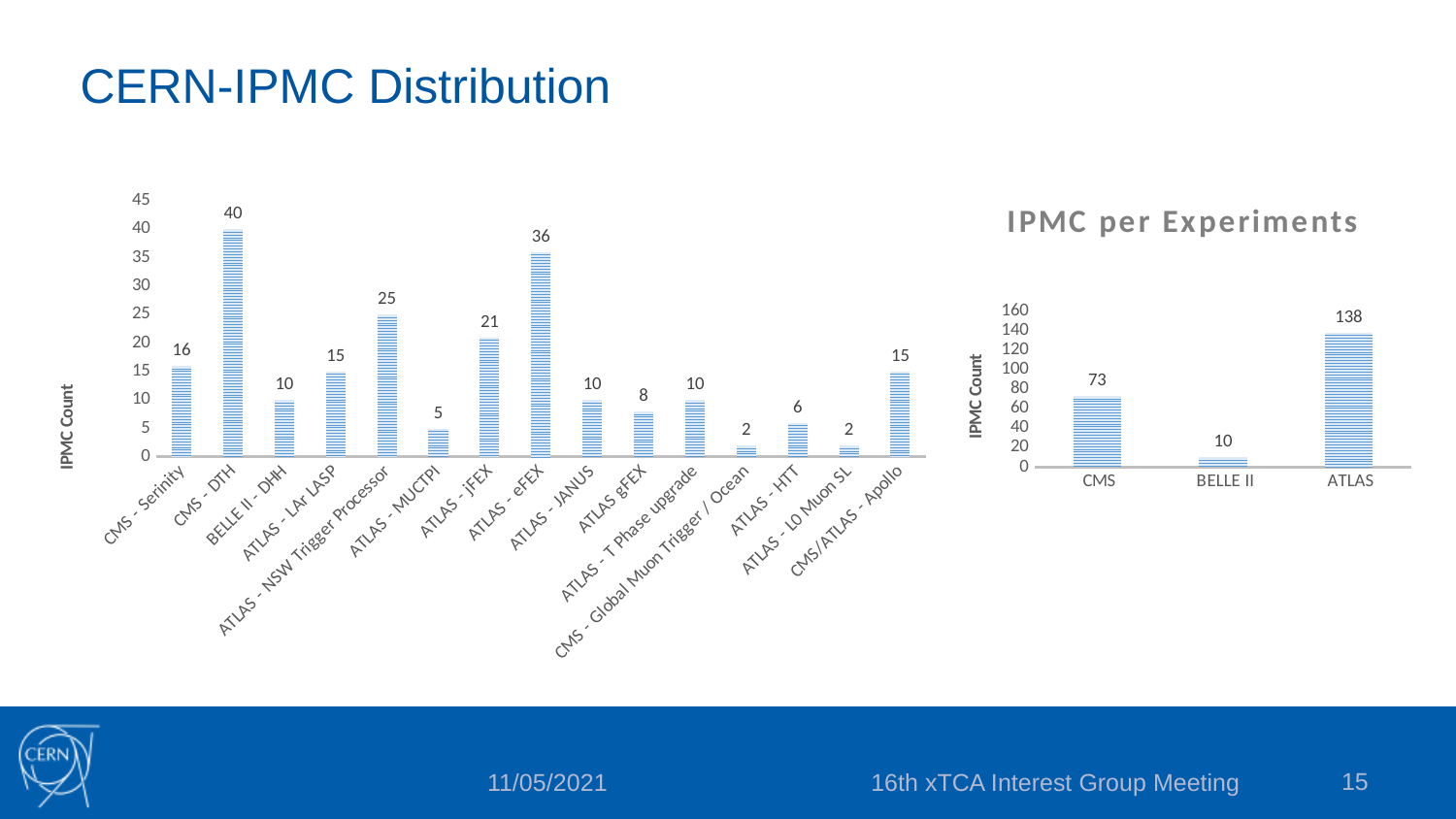
In the 'IPMC per Experiments' chart, what is the value for ATLAS? 138 In the left chart, which category has the highest IPMC count? CMS - DTH In the 'IPMC per Experiments' chart, what is the difference between the values for ATLAS and CMS? 65 In the left chart, how many categories are shown on the x axis? 15 In the left chart, what is the IPMC count for ATLAS - eFEX? 36 What kind of chart is the 'IPMC per Experiments' chart? Bar chart In the left chart, what is the IPMC count for ATLAS - MUCTPI? 5 In the left chart, what is the difference between the IPMC counts for CMS - DTH and ATLAS - eFEX? 4 In the left chart, which is larger, the IPMC count for ATLAS - jFEX or ATLAS - NSW Trigger Processor? ATLAS - NSW Trigger Processor In the left chart, what is the IPMC count for CMS - DTH? 40 In the 'IPMC per Experiments' chart, which experiment has the lowest value? BELLE II What is the y-axis label of the 'IPMC per Experiments' chart? IPMC Count